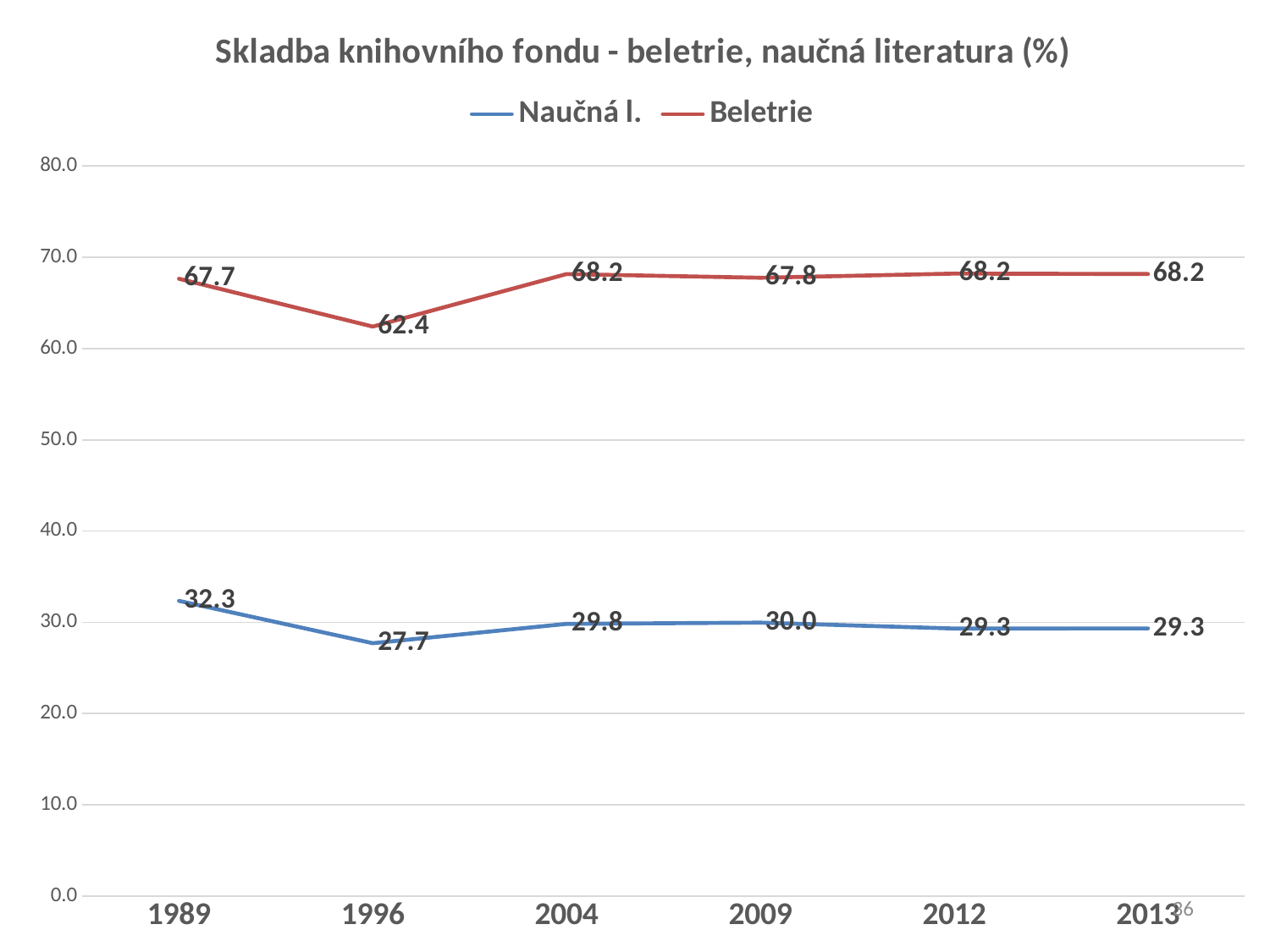
What is the title of the chart? Skladba knihovního fondu - beletrie, naučná literatura (%) What kind of chart is shown on the slide? Line chart Which series has the larger value in 2013, Naučná l. or Beletrie? Beletrie In which year is the Beletrie value lowest? 1996 What is the value for Naučná l. in 2009? 30.0 In which year is the Naučná l. value highest? 1989 What is the value for Beletrie in 1996? 62.4 How many years are shown on the x axis? 6 What is the difference between the Naučná l. value in 1989 and in 1996? 4.6 How many series does the legend list? 2 What is the difference between the Beletrie value in 2004 and in 1996? 5.8 What is the value for Naučná l. in 1989? 32.3